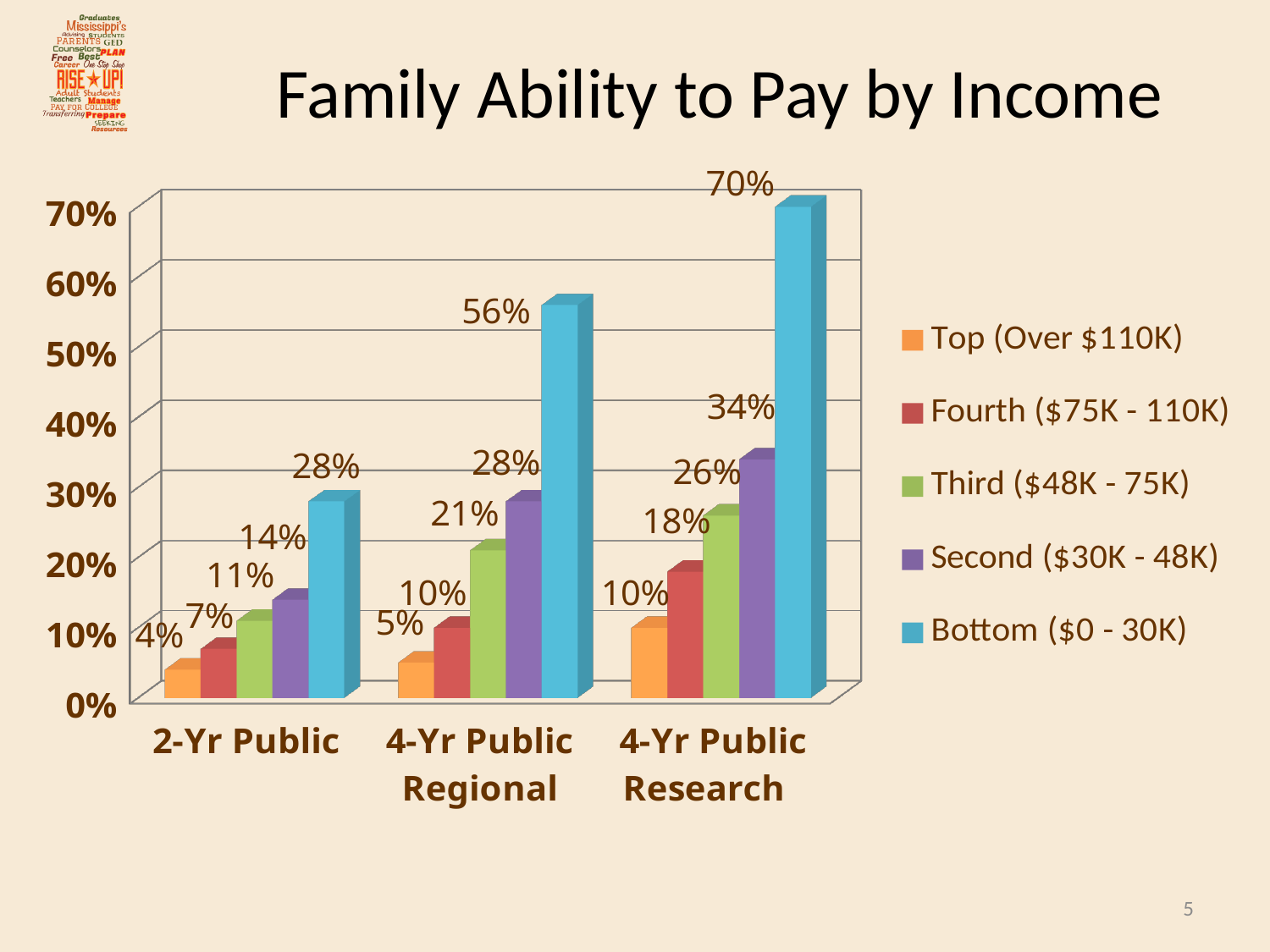
Which is larger: the Third ($48K - 75K) value at 4-Yr Public Research or the Second ($30K - 48K) value at 4-Yr Public Regional? Second ($30K - 48K) at 4-Yr Public Regional What is the difference between the Bottom ($0 - 30K) values for 4-Yr Public Research and 4-Yr Public Regional? 14% Do the Bottom ($0 - 30K) values rise or fall from 2-Yr Public to 4-Yr Public Research? Rise What kind of chart is shown on the slide? Bar chart What is the value for the Top (Over $110K) series at 2-Yr Public? 4% Which category has the highest value for the Bottom ($0 - 30K) series? 4-Yr Public Research How many series does the legend list? 5 What is the value for the Bottom ($0 - 30K) series at 4-Yr Public Research? 70% What is the value for the Second ($30K - 48K) series at 4-Yr Public Research? 34% What is the value for the Third ($48K - 75K) series at 4-Yr Public Regional? 21% How many categories are shown on the x axis? 3 Which category has the lowest value for the Fourth ($75K - 110K) series? 2-Yr Public